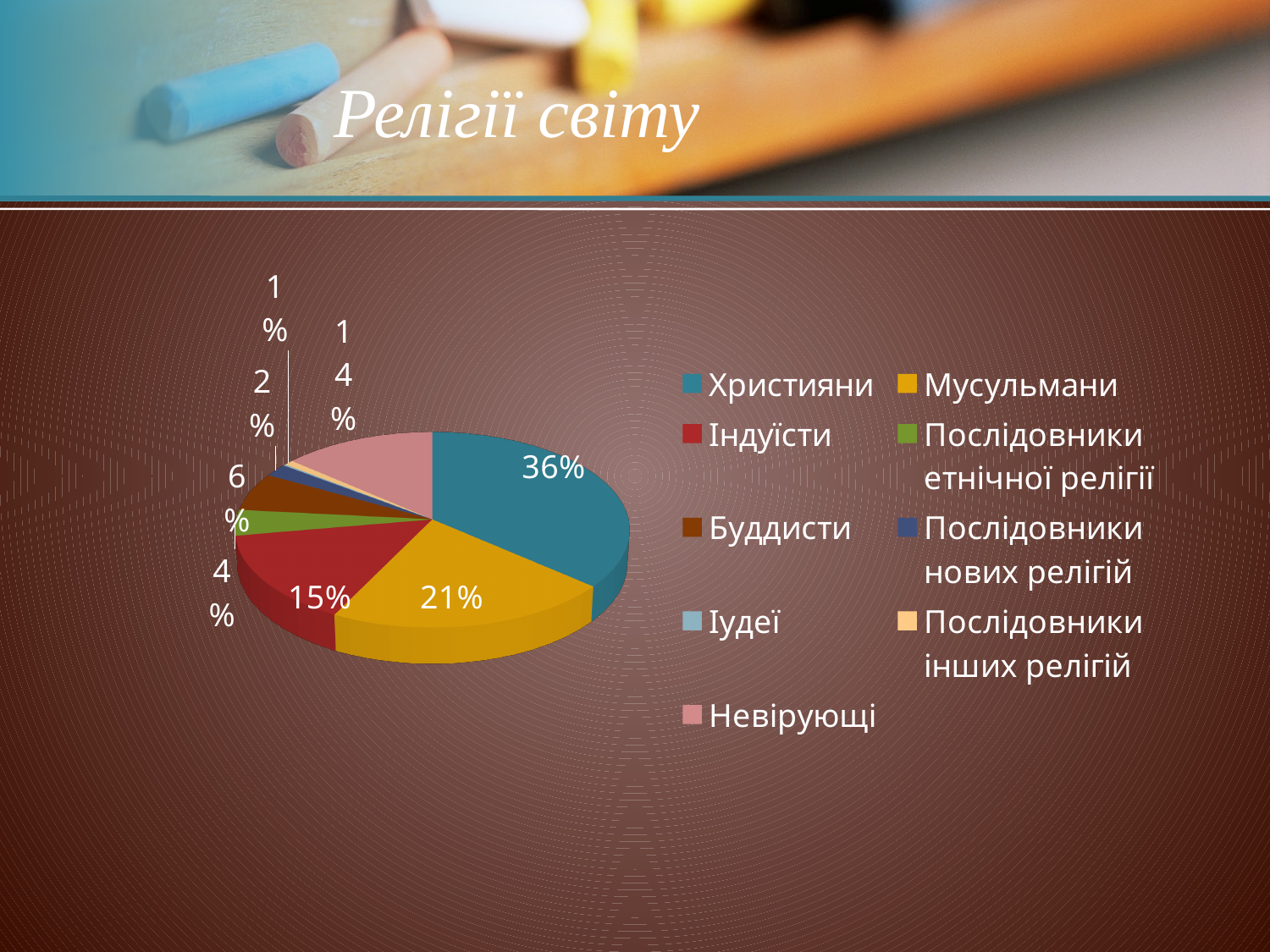
What share of the pie does Індуїсти have? 15% Which category has the largest slice of the pie chart? Християни What share of the pie does Невіруючі have? 14% Which is larger, the slice for Індуїсти or the slice for Невіруючі? Індуїсти What share of the pie does Християни have? 36% What colour is the slice for Мусульмани? yellow What is the title of the chart on the slide? Релігії світу What is the difference in percentage points between Християни and Мусульмани? 15 What kind of chart is shown on the slide? pie chart How many categories does the legend of the pie chart list? 9